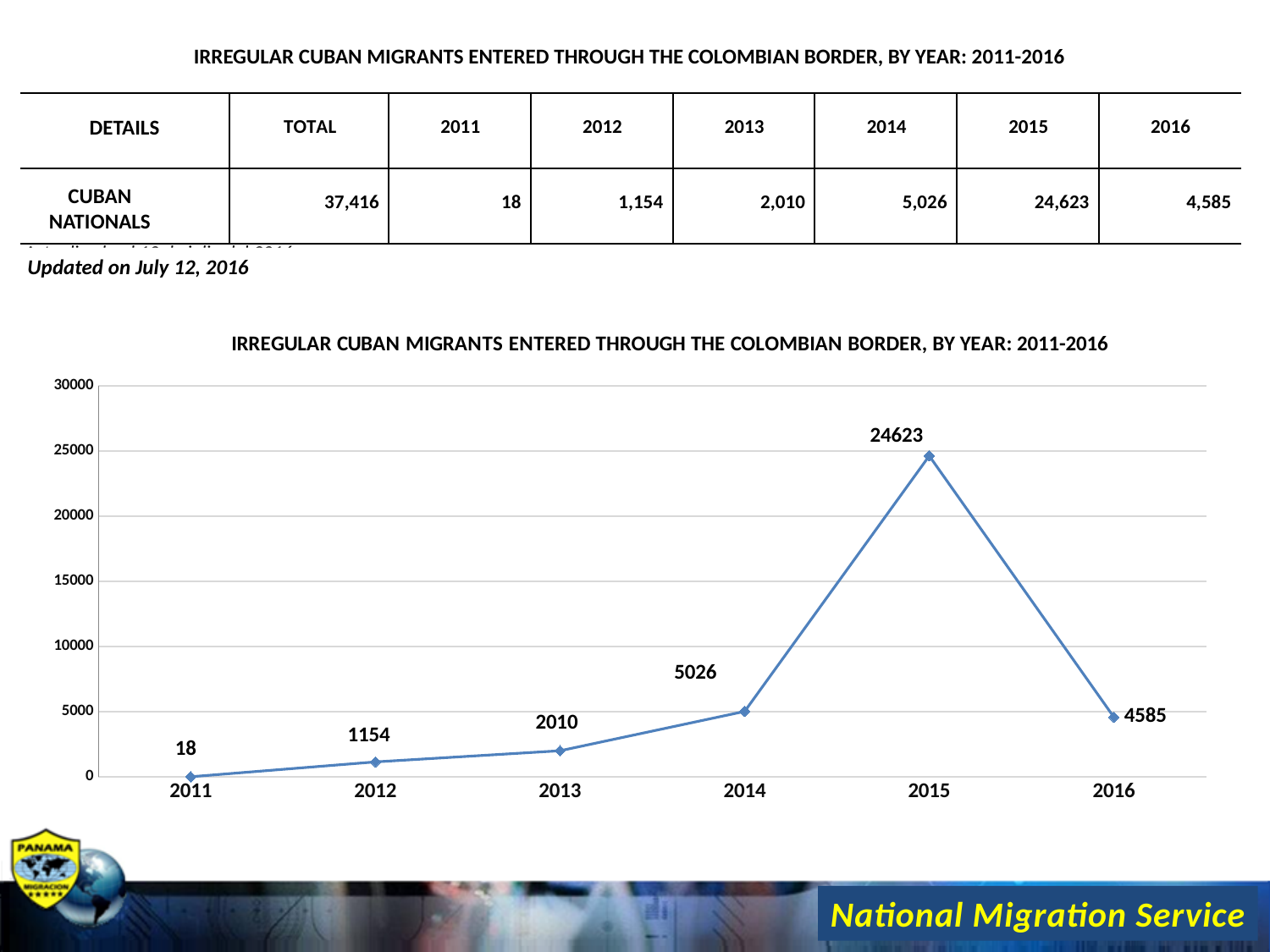
What type of chart is shown on the slide? line chart Is the value for 2015 greater or less than 20000? greater What is the difference between the values for 2015 and 2016? 20038 What is the value plotted for 2016? 4585 Which year has the highest value in the chart? 2015 Which year has a larger value, 2014 or 2016? 2014 What is the value plotted for 2013? 2010 How many years are plotted on the x axis of the chart? 6 What is the difference between the values for 2014 and 2013? 3016 Does the line rise or fall between 2015 and 2016? fall Which year has the lowest value in the chart? 2011 What is the value plotted for 2015? 24623